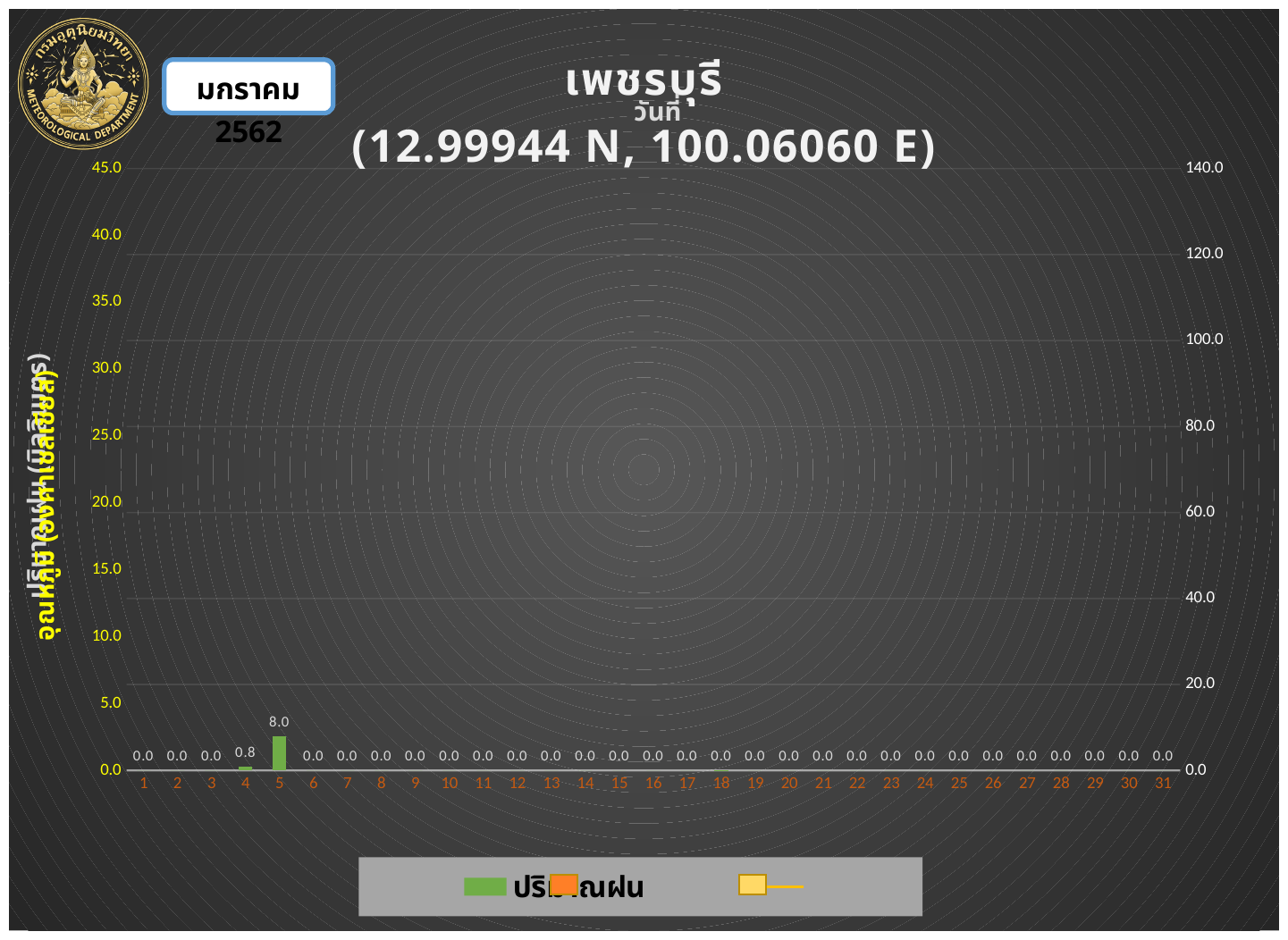
What is the rainfall value for day 1? 0.0 What is the rainfall value for day 5? 8.0 What is the highest tick value on the right vertical axis? 140.0 What is the difference between the rainfall values for day 5 and day 4? 7.2 How many days are shown on the x axis? 31 Is the rainfall value for day 5 greater or less than 10.0? less Which has the larger rainfall value, day 4 or day 5? day 5 What is the rainfall value for day 10? 0.0 What is the highest tick value on the left vertical axis? 45.0 Which day has the highest rainfall value? 5 What kind of chart is shown on the slide? bar chart What is the rainfall value for day 4? 0.8